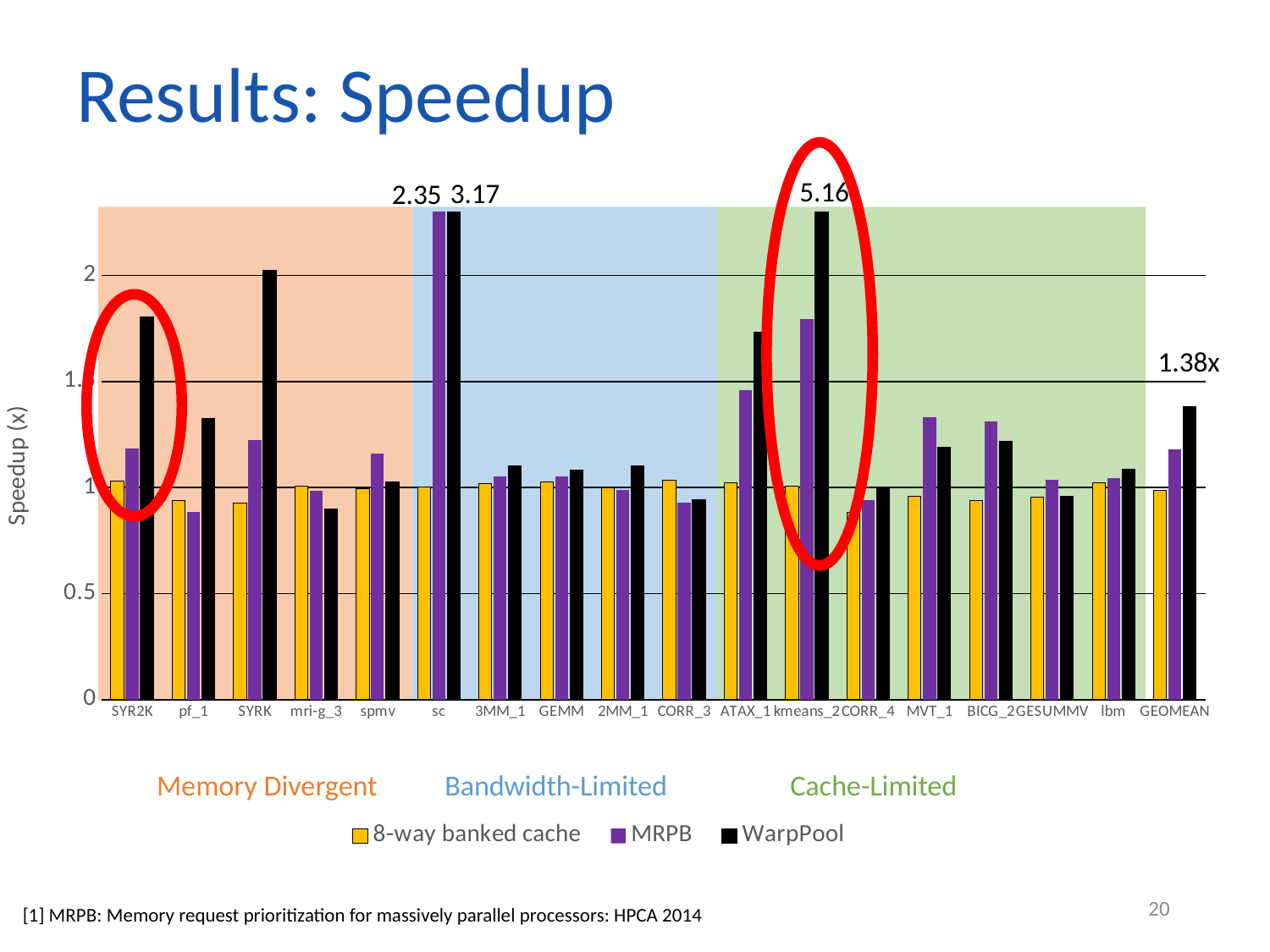
What is the WarpPool speedup for sc? 3.17 Is the WarpPool value for SYR2K greater or less than 1.5? greater What is the WarpPool value labelled for GEOMEAN? 1.38x How many categories are shown along the x axis? 18 How many series does the legend list? 3 What is the WarpPool speedup for kmeans_2? 5.16 What colour are the WarpPool bars? black What is the MRPB speedup for sc? 2.35 Which category has the highest WarpPool speedup? kmeans_2 For SYR2K, which is larger: the MRPB bar or the WarpPool bar? WarpPool For sc, what is the difference between the WarpPool and MRPB speedups? 0.82 What kind of chart is shown on the slide? bar chart